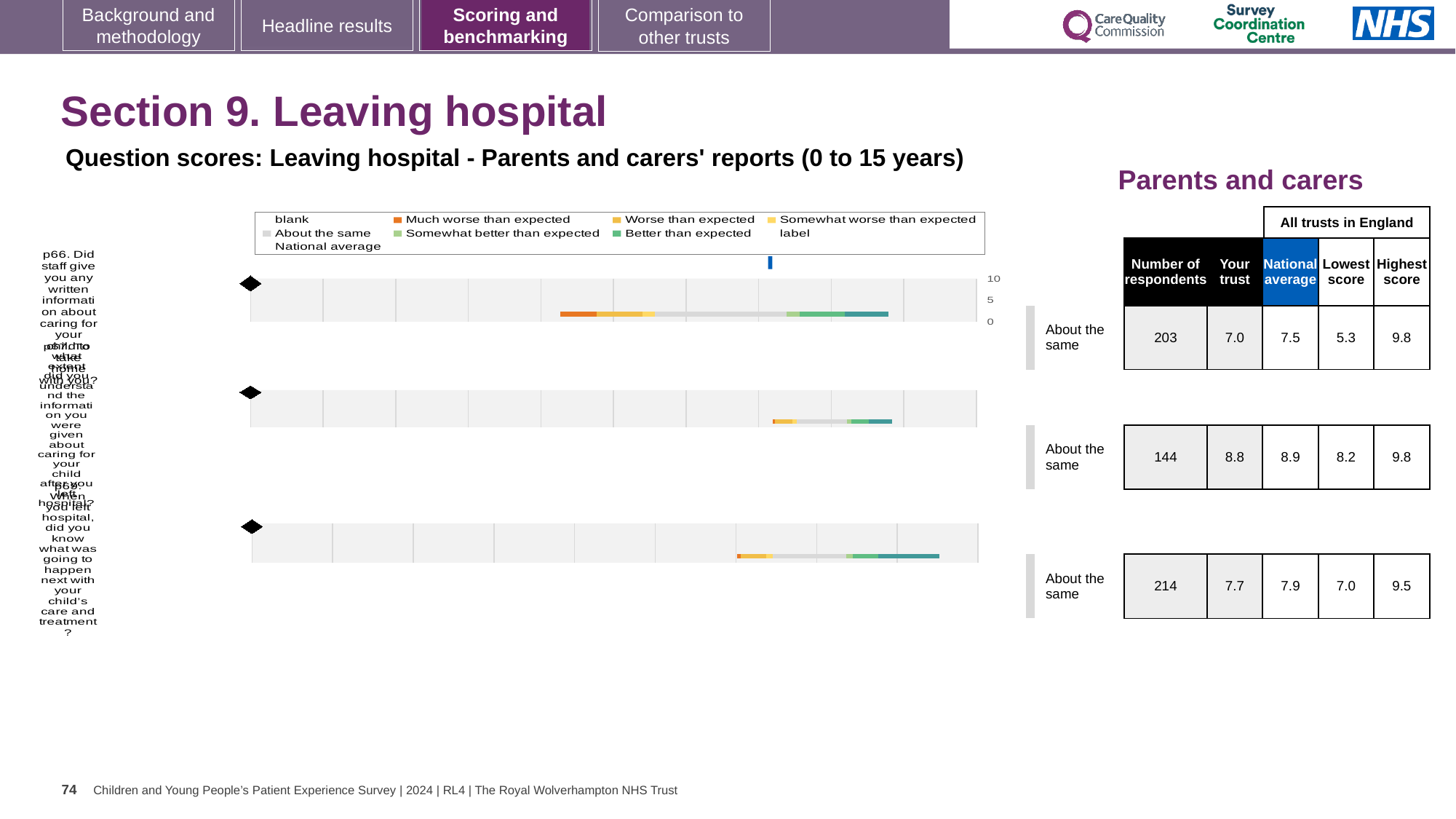
In the table beside the middle benchmark chart, how many respondents are listed? 144 For the bottom benchmark chart, what is the difference between the highest score (9.5) and the lowest score (7.0) in the table? 2.5 How many benchmark bar charts are shown on the slide? 3 What kind of chart is used for the three benchmark charts on the slide? bar chart Which of the three benchmark charts has the largest number of respondents in its table? The bottom chart (214) In the table beside the bottom benchmark chart, what is the highest score across all trusts in England? 9.5 What benchmark category label is shown next to each of the three charts? About the same In the table beside the top benchmark chart, what is the 'Your trust' score? 7.0 For the top benchmark chart, what is the difference between the highest score (9.8) and the lowest score (5.3) in the table? 4.5 What is the maximum value shown on the score axis of the top benchmark chart? 10 In the table beside the top benchmark chart, what is the national average score? 7.5 For the top benchmark chart, which is larger: the 'Your trust' score or the national average? National average